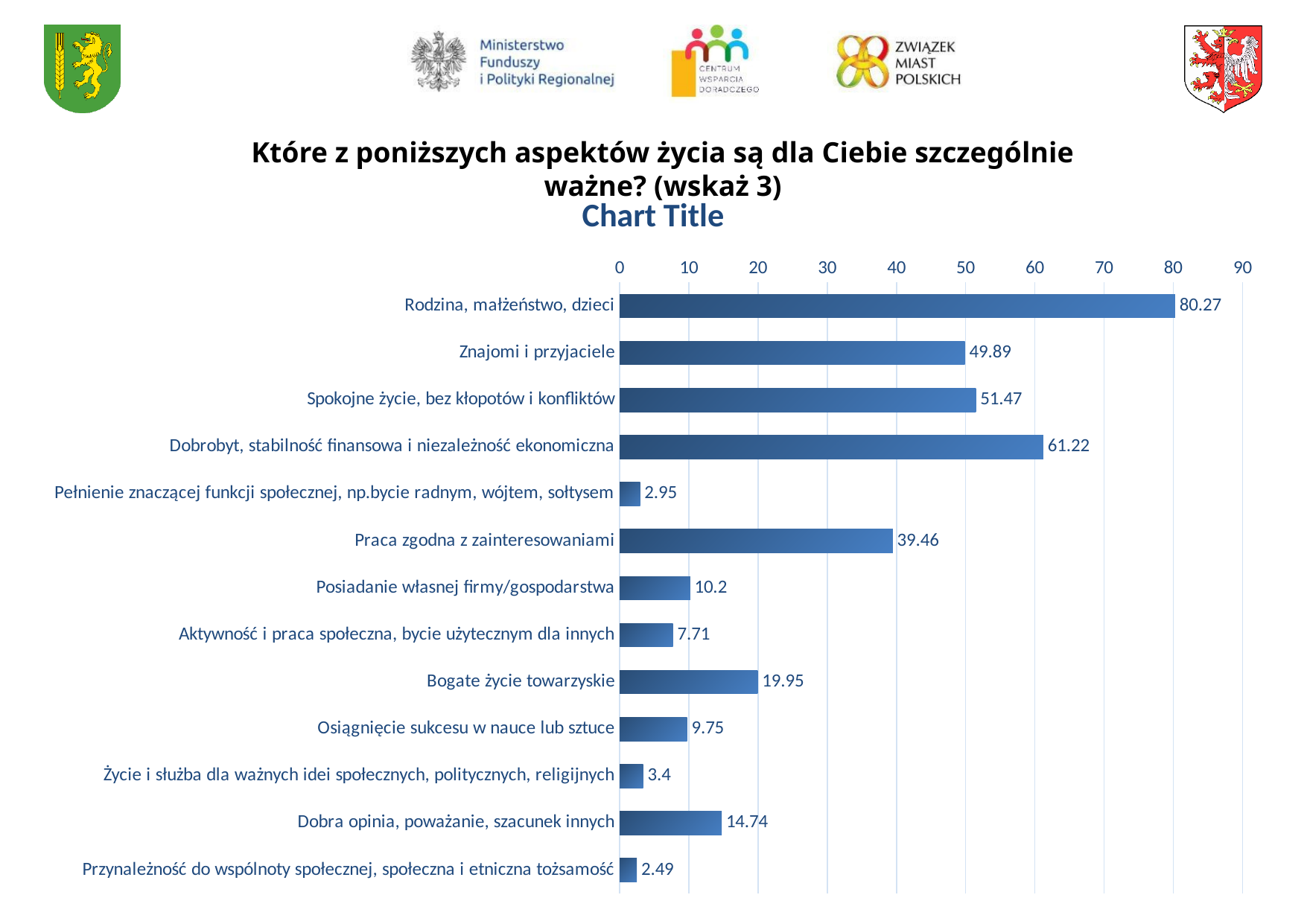
What is the value for "Posiadanie własnej firmy/gospodarstwa"? 10.2 Which category has the highest value? Rodzina, małżeństwo, dzieci What title is printed directly above the chart? Chart Title Which is larger: the value for "Spokojne życie, bez kłopotów i konfliktów" or for "Znajomi i przyjaciele"? Spokojne życie, bez kłopotów i konfliktów Is the value for "Dobra opinia, poważanie, szacunek innych" greater or less than 10? greater What is the difference between the values for "Rodzina, małżeństwo, dzieci" and "Dobrobyt, stabilność finansowa i niezależność ekonomiczna"? 19.05 How many categories are shown in the chart? 13 What is the value for "Rodzina, małżeństwo, dzieci"? 80.27 What kind of chart is shown on the slide? bar chart What is the value for "Praca zgodna z zainteresowaniami"? 39.46 Which category has the lowest value? Przynależność do wspólnoty społecznej, społeczna i etniczna tożsamość What is the value for "Dobra opinia, poważanie, szacunek innych"? 14.74